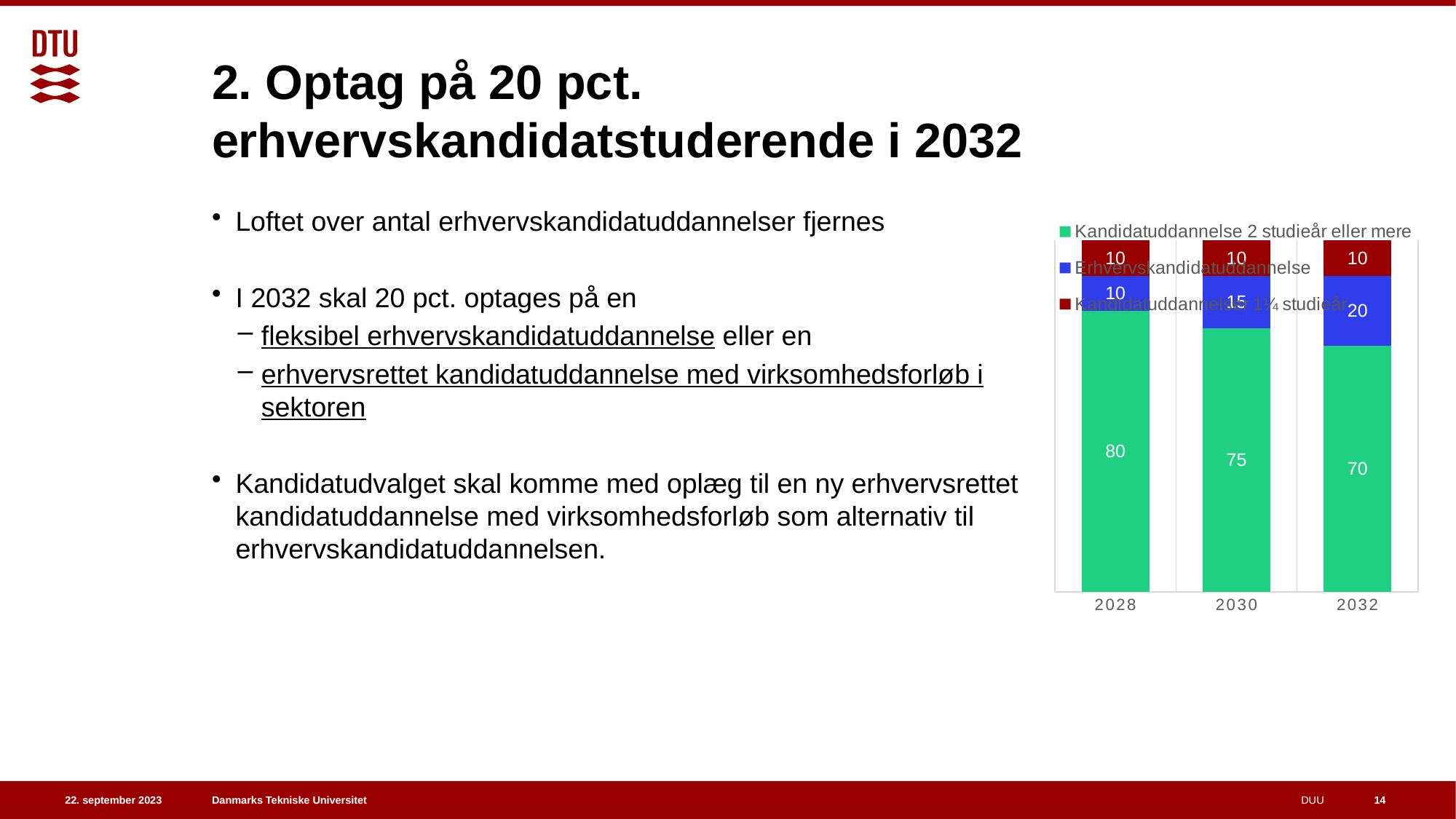
What kind of chart is shown on the slide? stacked bar chart What is the difference between the Kandidatuddannelse 2 studieår eller mere values for 2028 and 2032? 10 Does the value for Erhvervskandidatuddannelse rise or fall from 2028 to 2032? rise In which year is the value for Kandidatuddannelse 2 studieår eller mere lowest? 2032 What is the value for Kandidatuddannelse 2 studieår eller mere in 2030? 75 What is the value for Kandidatuddannelse 2 studieår eller mere in 2028? 80 What is the value for Erhvervskandidatuddannelse in 2032? 20 How many series does the chart legend list? 3 In which year is the value for Erhvervskandidatuddannelse highest? 2032 What is the total of the stacked bar for 2030? 100 How many categories are shown on the x axis of the chart? 3 What is the value for Erhvervskandidatuddannelse in 2030? 15